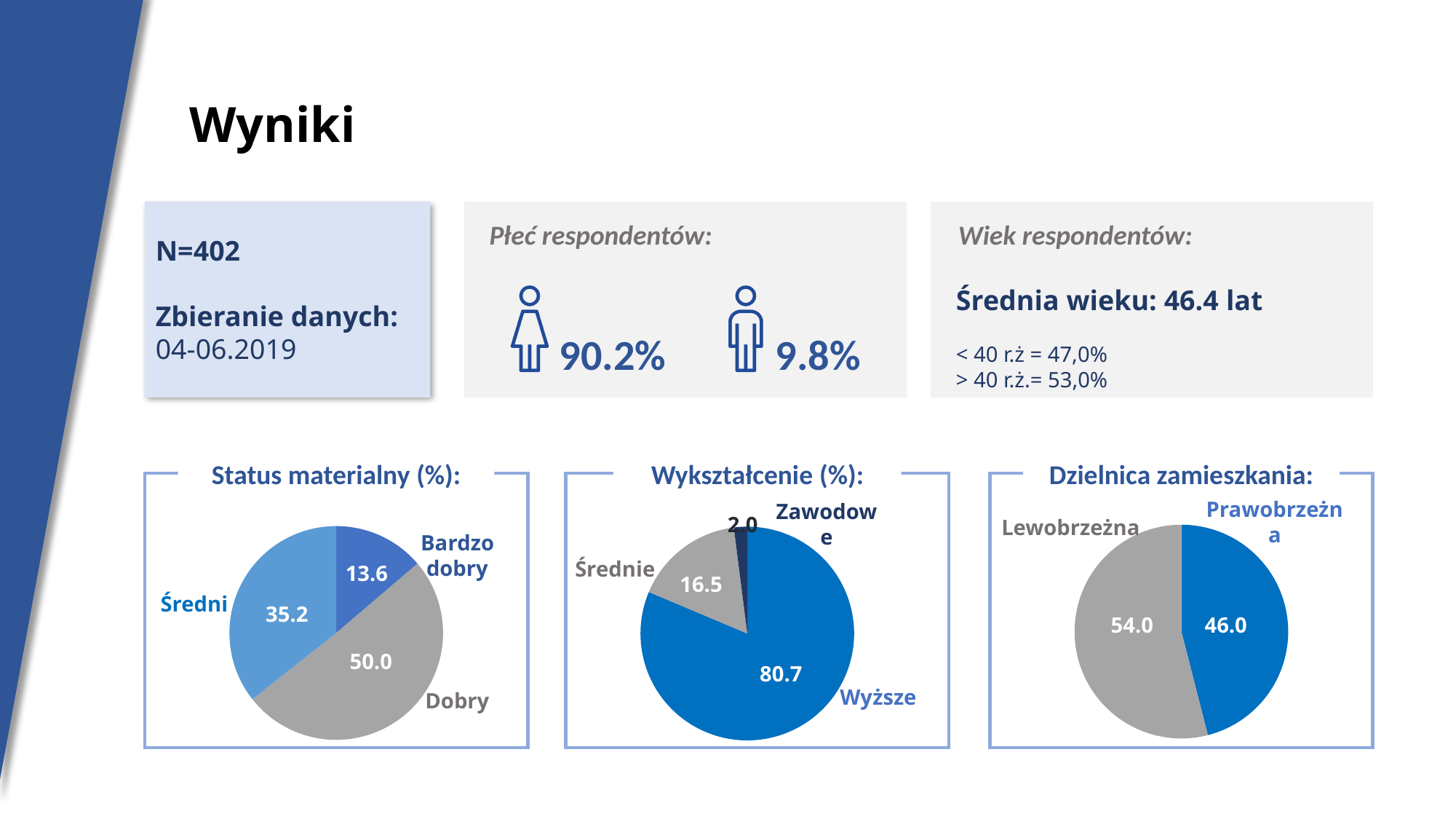
In the 'Dzielnica zamieszkania' chart, what is the difference between Lewobrzeżna and Prawobrzeżna? 8.0 How many pie charts are shown on the slide? 3 In the 'Wykształcenie (%)' chart, which category has the largest slice? Wyższe In the 'Dzielnica zamieszkania' chart, what is the value for Lewobrzeżna? 54.0 What type of chart is used for 'Status materialny (%)'? Pie chart In the 'Status materialny (%)' chart, what is the value for Dobry? 50.0 In the 'Wykształcenie (%)' chart, how many categories are shown? 3 In the 'Wykształcenie (%)' chart, what is the value for Zawodowe? 2.0 In the 'Wykształcenie (%)' chart, what is the value for Wyższe? 80.7 In the 'Dzielnica zamieszkania' chart, which is larger, Lewobrzeżna or Prawobrzeżna? Lewobrzeżna In the 'Status materialny (%)' chart, what is the difference between Średni and Bardzo dobry? 21.6 In the 'Status materialny (%)' chart, which category has the smallest slice? Bardzo dobry